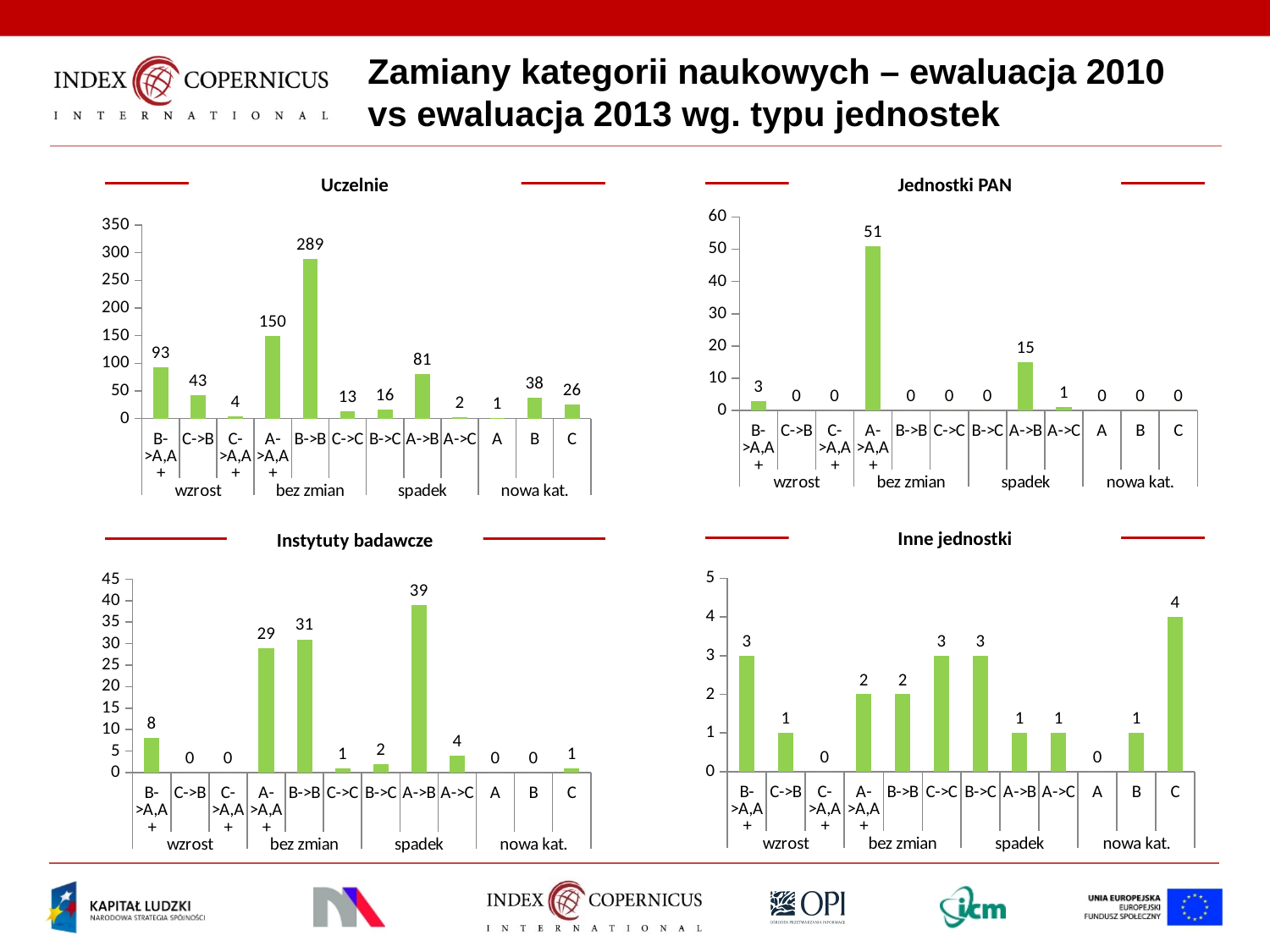
In the Jednostki PAN chart, which category has the highest value? A->A,A+ In the Inne jednostki chart, what is the value for B->A,A+? 3 How many categories are shown on the x axis of the Uczelnie chart? 12 In the Instytuty badawcze chart, which is larger, the value for A->A,A+ or the value for B->B? B->B In the Inne jednostki chart, which category has the highest value? C In the Uczelnie chart, what is the difference between the values for A->A,A+ and B->A,A+? 57 In the Uczelnie chart, which category has the highest value? B->B How many charts are shown on the slide? 4 In the Instytuty badawcze chart, what is the value for A->B? 39 What type of chart is the Jednostki PAN chart? bar chart In the Uczelnie chart, what is the value for B->B? 289 In the Jednostki PAN chart, what is the value for A->B? 15